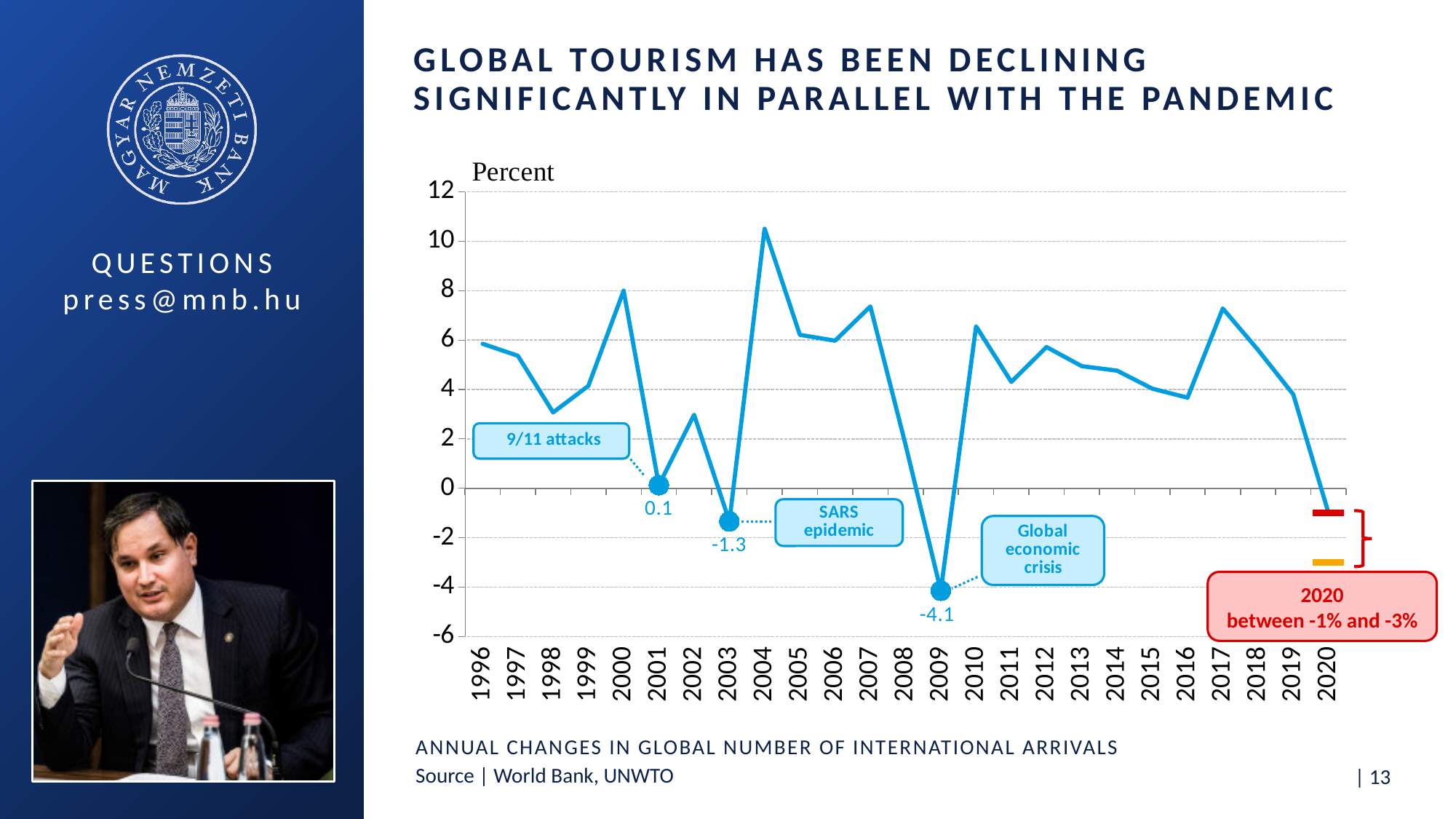
Is the value for 2000 greater or less than 6? greater Which event is annotated at the 2009 data point? Global economic crisis What is the value for 2001? 0.1 Which year has the lowest value? 2009 Which year has the highest value? 2004 What is the difference between the values for 2003 and 2009? 2.8 What is the value for 2003? -1.3 Is the value for 1998 greater or less than 4? less What is the value for 2009? -4.1 What kind of chart is shown? line chart Which is larger, the value for 2004 or the value for 2007? 2004 How many years are shown on the x axis? 25